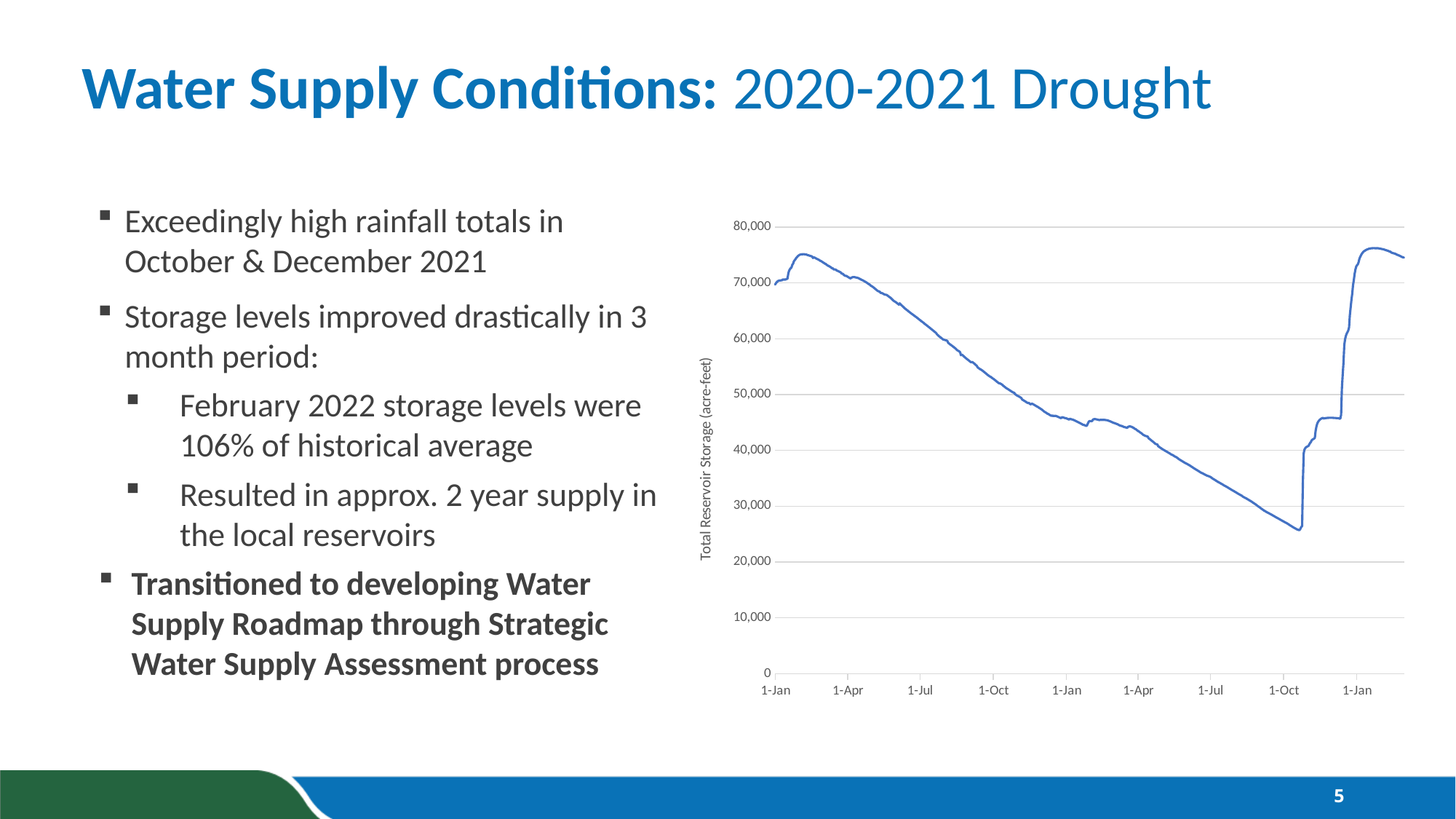
What kind of chart is shown on the slide? line chart Is the lowest point of the line on the chart greater or less than 30,000? less Is the value at the second 1-Oct on the chart greater or less than 30,000? less What is the highest value shown on the vertical axis of the chart? 80,000 Is the value at the first 1-Jul on the chart greater or less than 60,000? greater What is the label on the vertical axis of the chart? Total Reservoir Storage (acre-feet) Which labelled date on the x axis has the lowest reservoir storage value? the second 1-Oct Which has the larger reservoir storage value, the first 1-Jul or the second 1-Jul? the first 1-Jul Does the reservoir storage rise or fall between the first 1-Jan and the second 1-Oct? fall